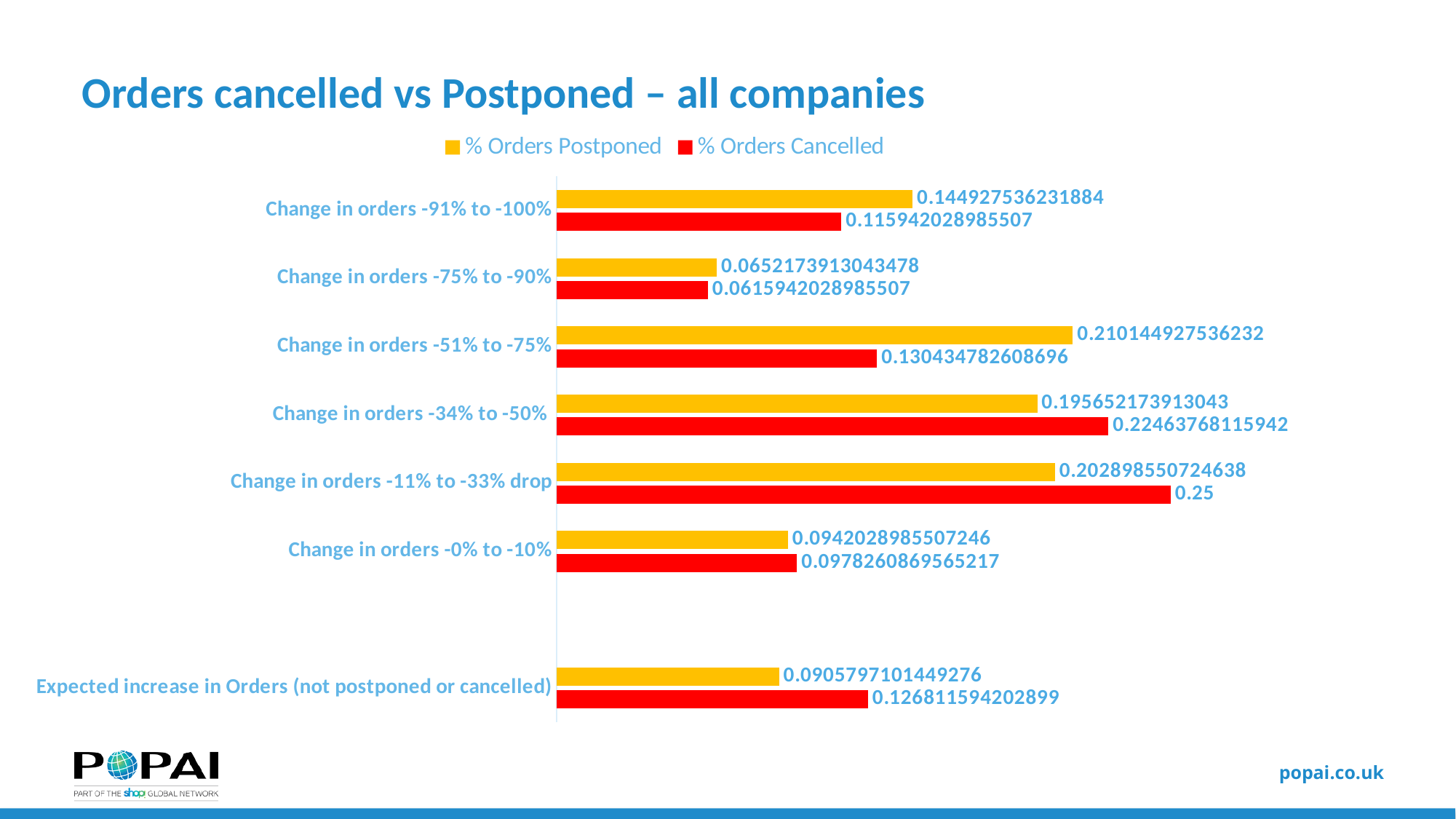
Which category has the highest % Orders Postponed value? Change in orders -51% to -75% What is the difference between % Orders Postponed and % Orders Cancelled for 'Change in orders -91% to -100%'? 0.028985507246377 How many series does the legend list? 2 What is the % Orders Cancelled value for 'Expected increase in Orders (not postponed or cancelled)'? 0.126811594202899 For 'Change in orders -51% to -75%', which is larger: % Orders Postponed or % Orders Cancelled? % Orders Postponed Which category has the lowest % Orders Cancelled value? Change in orders -75% to -90% What is the % Orders Postponed value for 'Change in orders -91% to -100%'? 0.144927536231884 Which category has the highest % Orders Cancelled value? Change in orders -11% to -33% drop What is the title of the chart? Orders cancelled vs Postponed – all companies What is the % Orders Cancelled value for 'Change in orders -11% to -33% drop'? 0.25 What type of chart is shown on the slide? Bar chart For 'Change in orders -34% to -50%', which is larger: % Orders Postponed or % Orders Cancelled? % Orders Cancelled